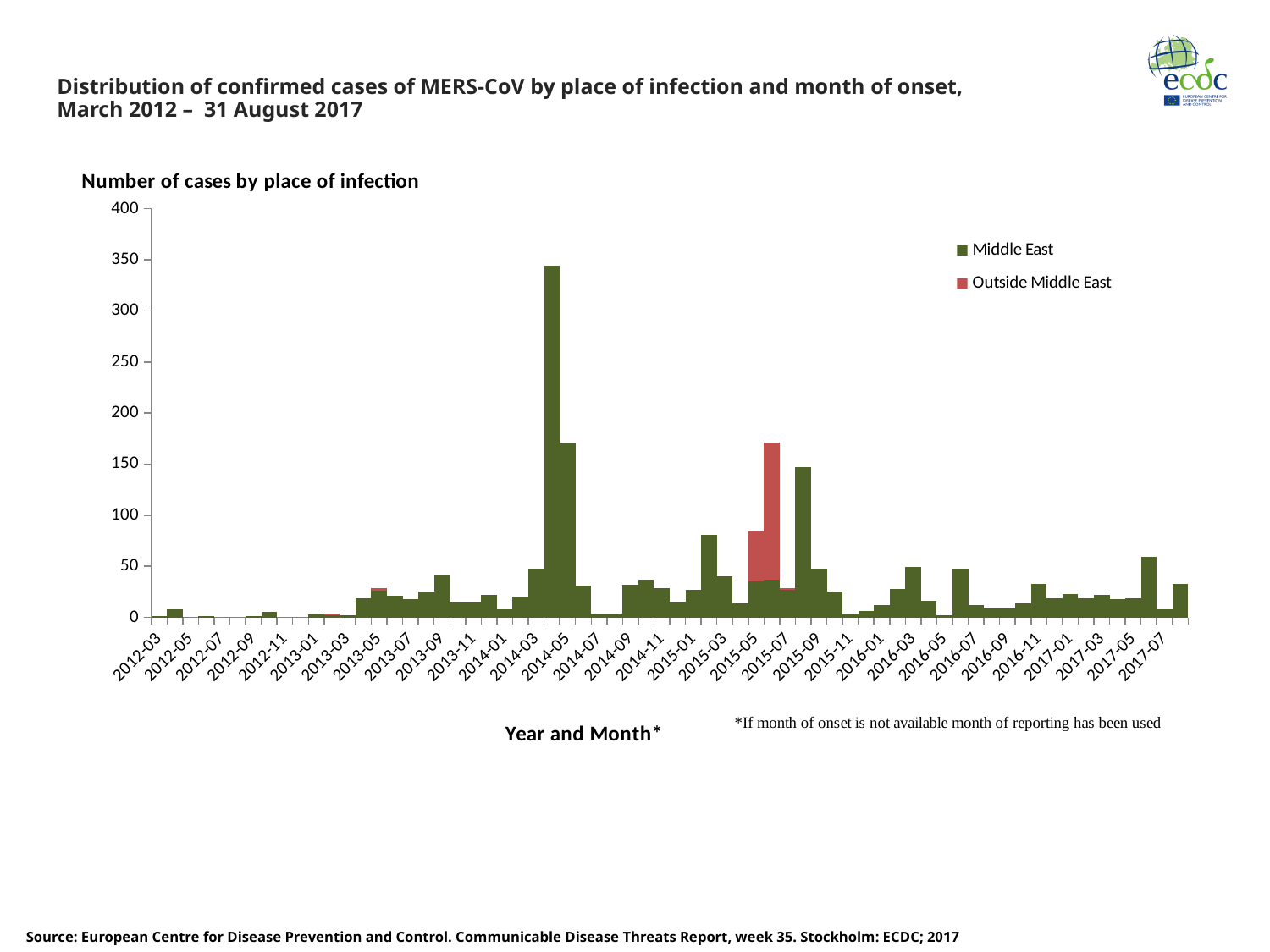
Is the value for 2017-07 greater or less than 50? less Which series has the tallest single bar in the chart, Middle East or Outside Middle East? Middle East Which colour represents the Outside Middle East series? red What kind of chart is shown on the slide? bar chart What is the highest value shown on the vertical axis? 400 How many series does the legend list? 2 Is the tallest bar in the chart greater or less than 300? greater Is the value for 2012-03 greater or less than 50? less What are the two series named in the legend? Middle East and Outside Middle East